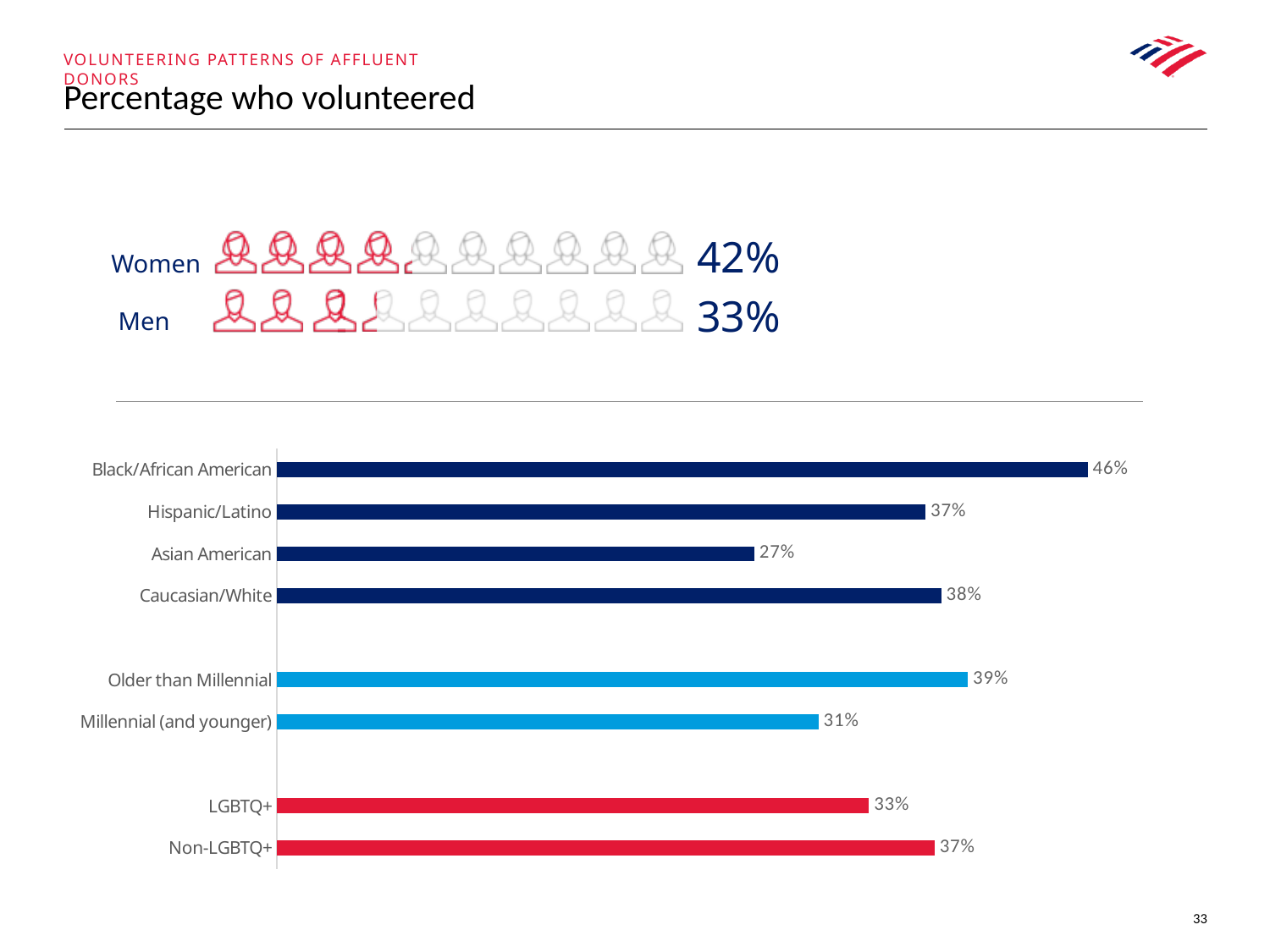
What kind of chart is the lower chart on the slide? Bar chart In the pictograph at the top of the slide, what percentage of women volunteered? 42% In the bar chart, which category has the lowest value? Asian American In the bar chart, what is the value for Asian American? 27% In the bar chart, what is the value for Black/African American? 46% In the bar chart, what is the value for Millennial (and younger)? 31% How many categories are shown in the bar chart? 8 In the bar chart, which category has the highest value? Black/African American In the bar chart, what is the difference between Non-LGBTQ+ and LGBTQ+? 4% In the bar chart, what is the difference between Older than Millennial and Millennial (and younger)? 8% In the pictograph at the top of the slide, what is the difference between the women and men percentages? 9% In the bar chart, which is larger, Caucasian/White or Hispanic/Latino? Caucasian/White